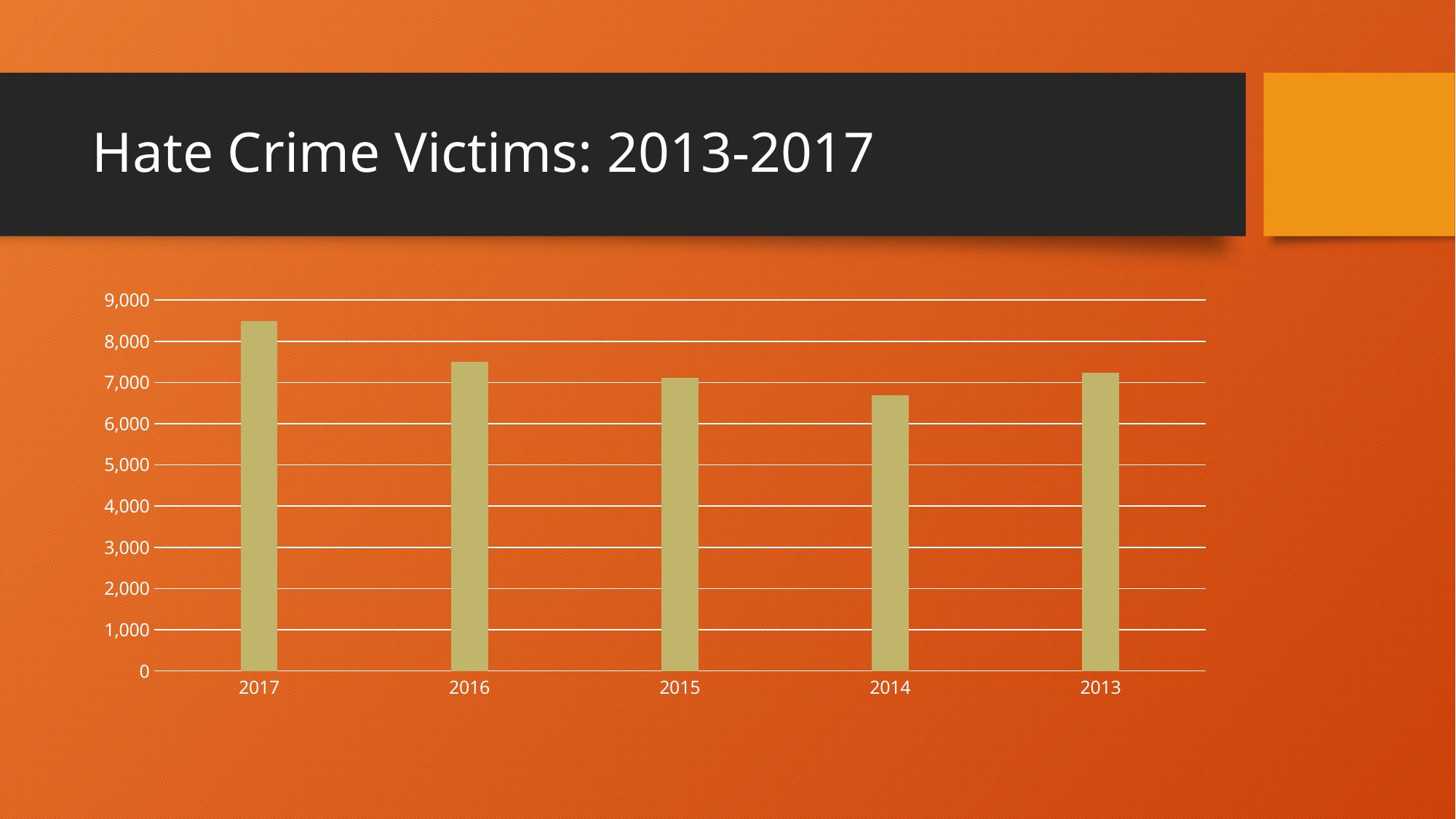
Is the value for 2017 greater or less than 8,000? greater What kind of chart is shown on the slide? bar chart Which year has a larger value, 2017 or 2016? 2017 Which year has a larger value, 2016 or 2014? 2016 How many years are shown on the x axis of the chart? 5 What is the highest value labelled on the y axis of the chart? 9,000 What is the title of the chart on the slide? Hate Crime Victims: 2013-2017 Which year has the highest number of hate crime victims? 2017 Is the value for 2014 greater or less than 7,000? less Is the value for 2014 greater or less than 6,000? greater Which year has the lowest number of hate crime victims? 2014